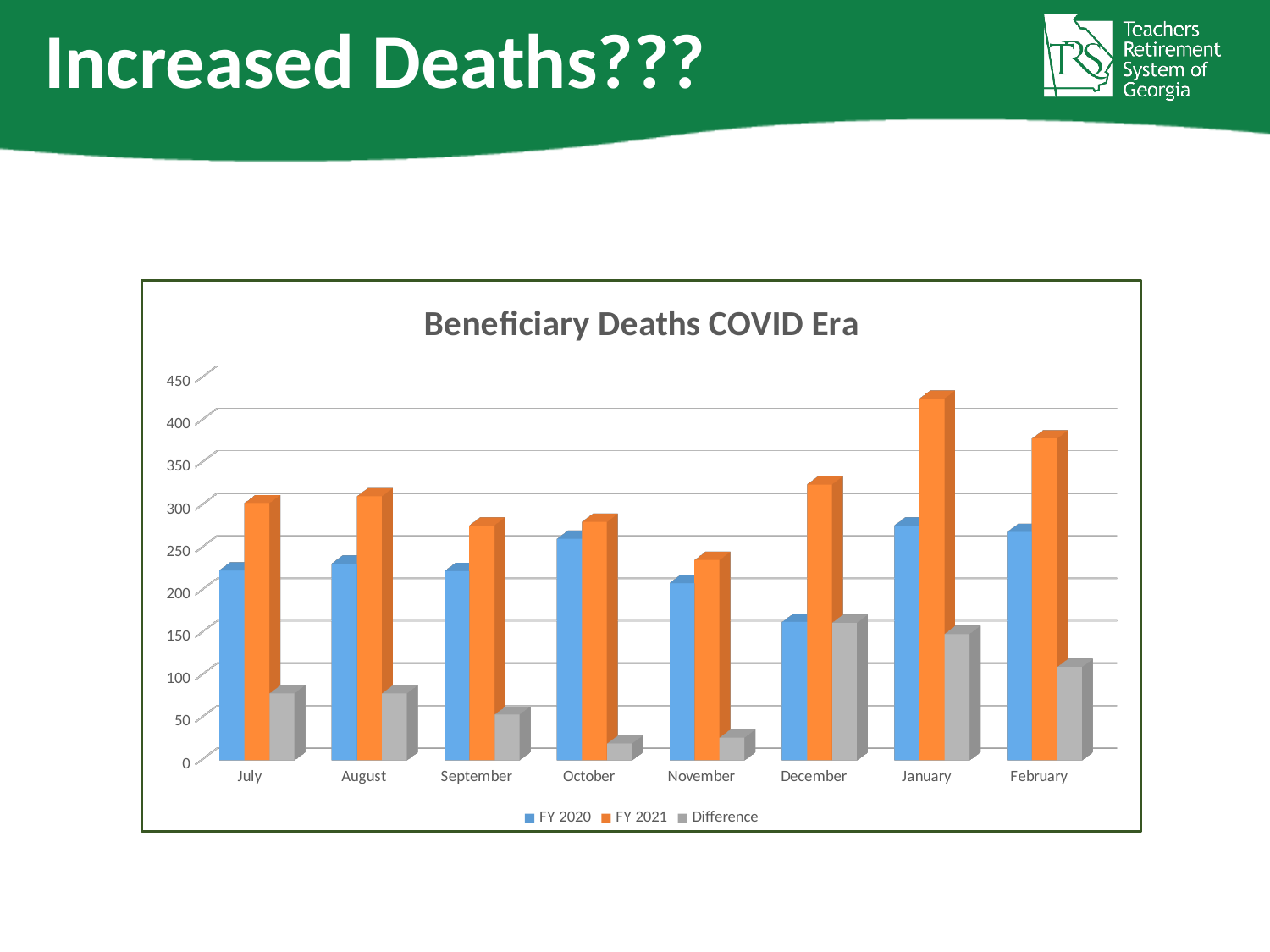
In January, which is larger: the FY 2020 value or the FY 2021 value? FY 2021 Does the FY 2021 series rise or fall from November to January? rise Which month has the highest FY 2021 value? January Is the FY 2020 value for December greater or less than 200? less How many series does the legend list? 3 Which month has the lowest FY 2020 value? December Is the FY 2021 value for January greater or less than 400? greater Which month has the lowest FY 2021 value? November Is the Difference value for October greater or less than 50? less What kind of chart is shown on the slide? bar chart How many months are shown on the x axis? 8 What is the title of the chart? Beneficiary Deaths COVID Era